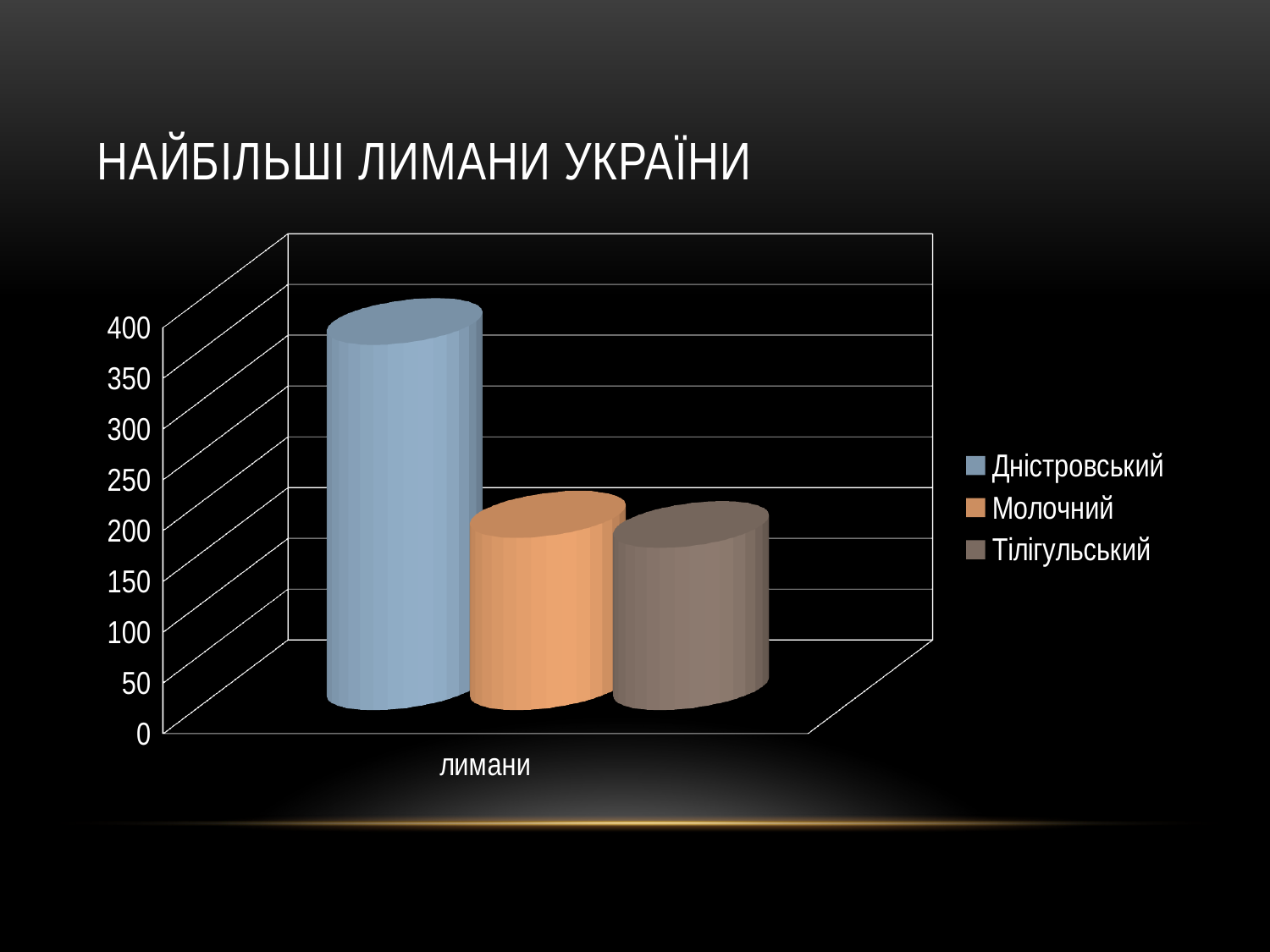
Which series has the highest value? Дністровський What kind of chart is shown on the slide? bar chart Is the value for Молочний greater or less than 100? greater Is the value for Молочний greater or less than 250? less Is the value for Тілігульський greater or less than 250? less Which is larger, the value for Тілігульський or the value for Дністровський? Дністровський What is the title of the slide? НАЙБІЛЬШІ ЛИМАНИ УКРАЇНИ Which is larger, the value for Дністровський or the value for Молочний? Дністровський How many categories are shown on the x axis? 1 What is the label of the category on the x axis? лимани How many series does the legend list? 3